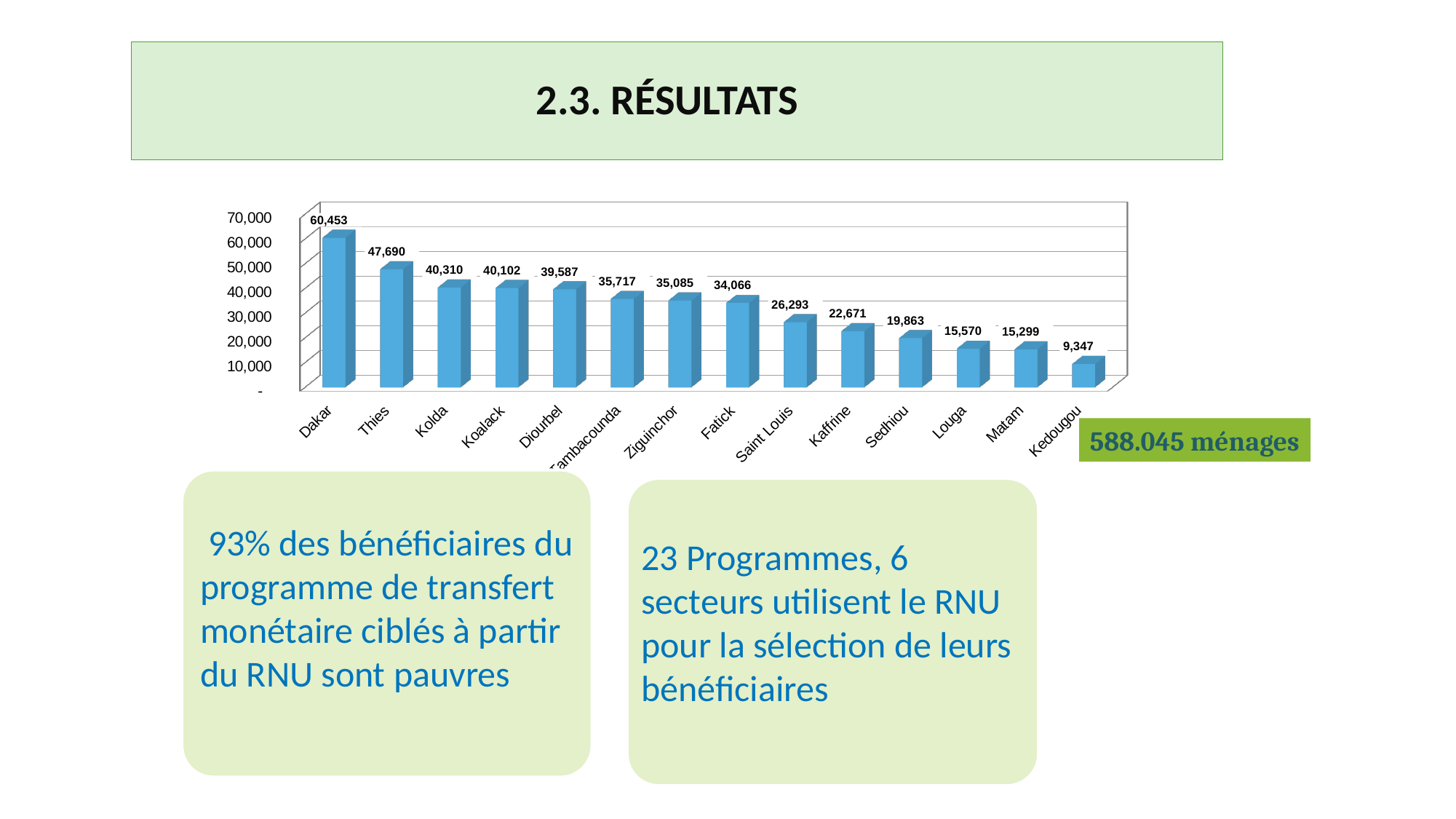
What kind of chart is shown on the slide? Bar chart Is the value for Thies greater or less than 40,000? greater What is the difference between the values for Dakar and Thies? 12,763 What is the difference between the values for Saint Louis and Kaffrine? 3,622 Which region has the highest value? Dakar What is the value for Dakar? 60,453 Which is larger, the value for Fatick or the value for Sedhiou? Fatick Which region has the lowest value? Kedougou What is the value for Kedougou? 9,347 How many regions are shown on the x axis? 14 What is the value for Tambacounda? 35,717 Do the values rise or fall from left to right along the x axis? Fall